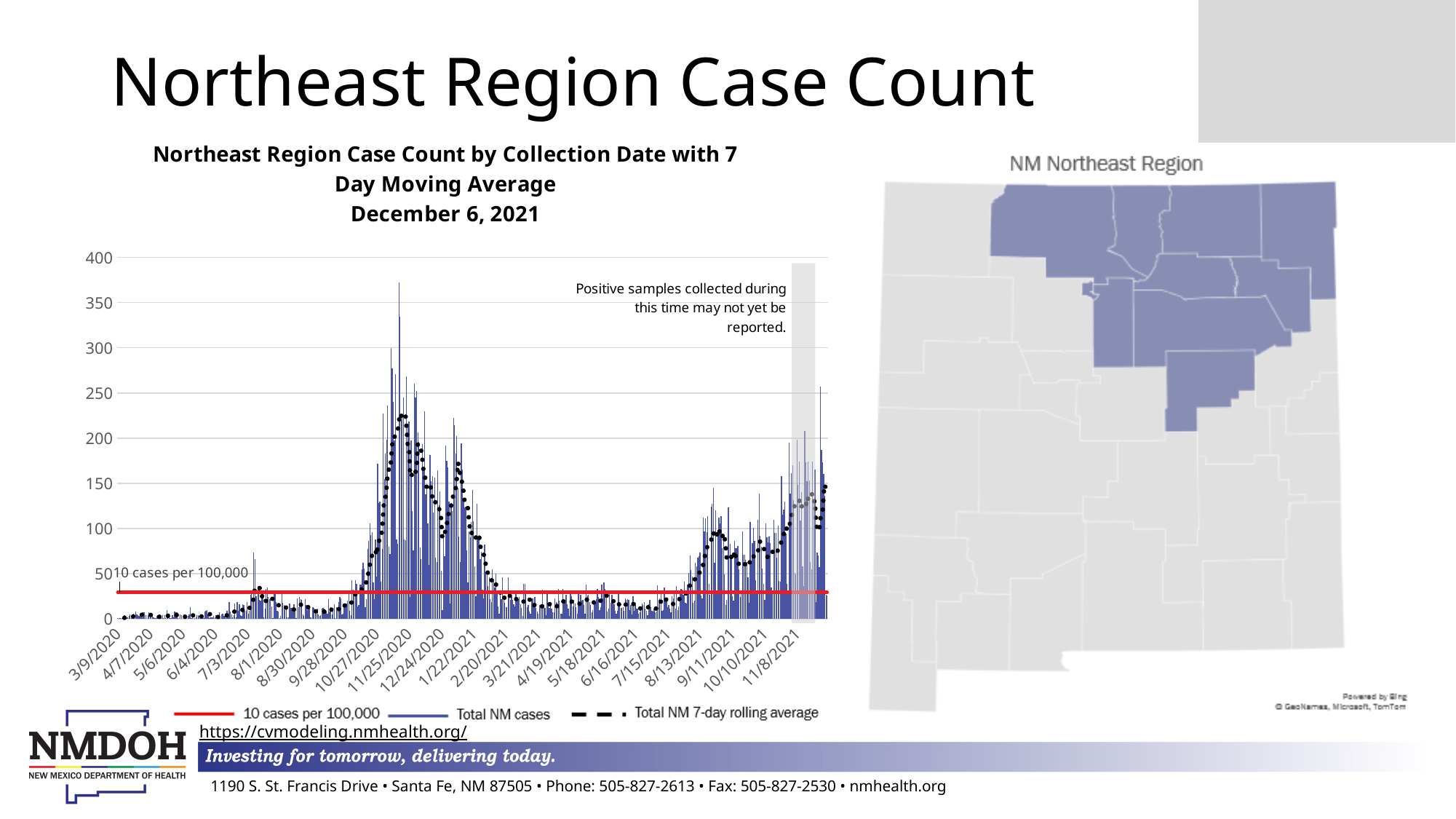
Is the tallest daily case bar on the chart, near 11/25/2020, greater or less than 300? greater What is the first date label on the chart's horizontal axis? 3/9/2020 What kind of chart is shown on the slide? bar chart with line overlays Is the peak of the 7-day rolling average near 11/25/2020 greater or less than 200? greater Between 11/25/2020 and 2/20/2021, does the 7-day rolling average rise or fall? fall What is the highest value shown on the chart's vertical axis? 400 What is the last date label on the chart's horizontal axis? 11/8/2021 How many series does the chart legend list? 3 Which peak in the 7-day rolling average is higher: the one around 11/25/2020 or the one around 9/11/2021? 11/25/2020 Is the 7-day rolling average around 5/18/2021 greater or less than 50? less What does the red horizontal line on the chart represent, according to the legend? 10 cases per 100,000 What is the title of the chart on the left of the slide? Northeast Region Case Count by Collection Date with 7 Day Moving Average December 6, 2021